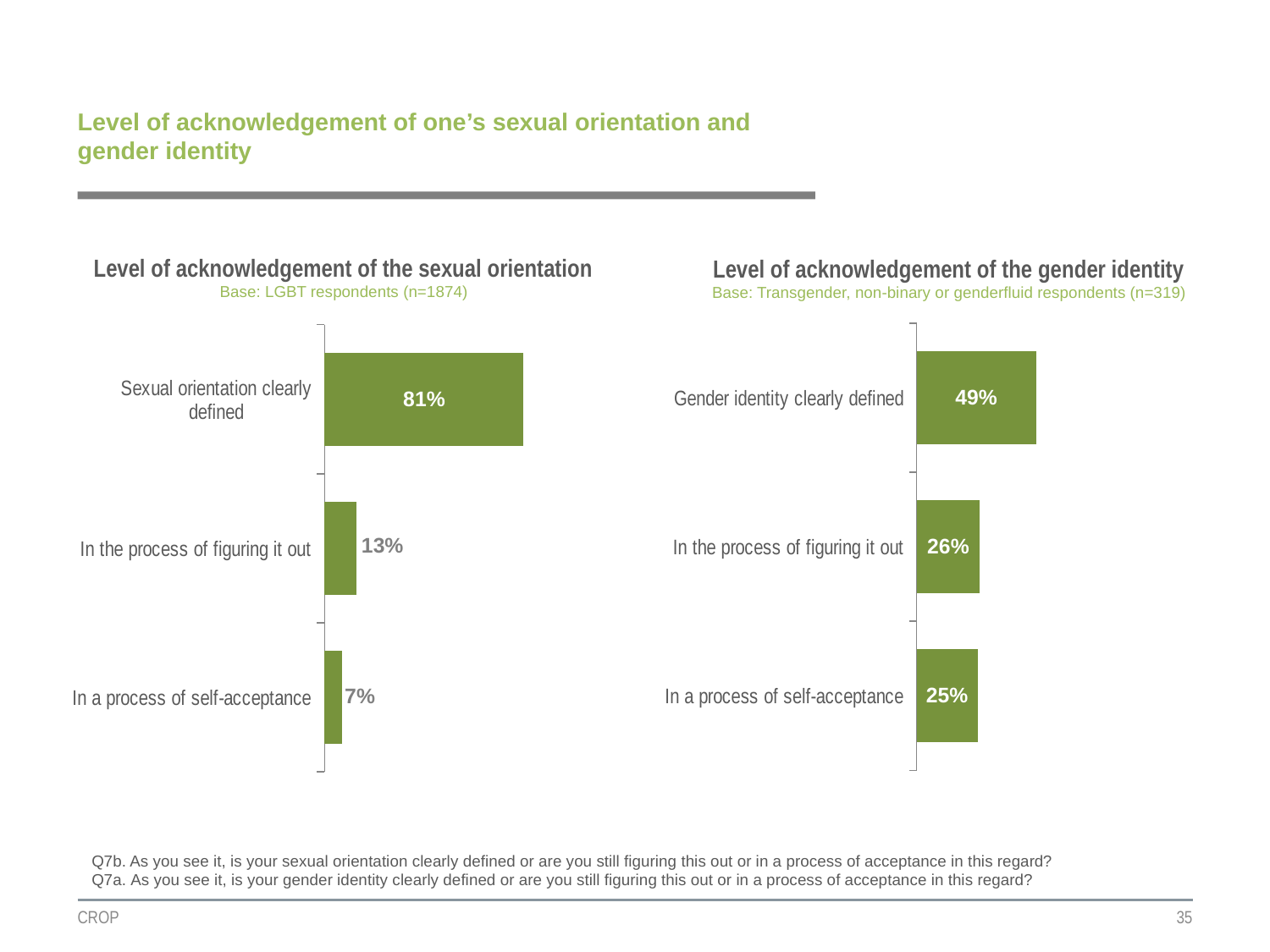
In the 'Level of acknowledgement of the sexual orientation' chart, what is the difference between 'Sexual orientation clearly defined' and 'In the process of figuring it out'? 68% How many categories does the 'Level of acknowledgement of the gender identity' chart show? 3 In the 'Level of acknowledgement of the gender identity' chart, what is the value for 'In the process of figuring it out'? 26% What is the base sample size shown under the 'Level of acknowledgement of the sexual orientation' chart title? n=1874 In the 'Level of acknowledgement of the sexual orientation' chart, what is the value for 'Sexual orientation clearly defined'? 81% In the 'Level of acknowledgement of the gender identity' chart, which category has the highest value? Gender identity clearly defined What kind of chart is the 'Level of acknowledgement of the sexual orientation' chart? Bar chart In the 'Level of acknowledgement of the gender identity' chart, what is the difference between 'Gender identity clearly defined' and 'In a process of self-acceptance'? 24% In the 'Level of acknowledgement of the sexual orientation' chart, what is the value for 'In a process of self-acceptance'? 7% In the 'Level of acknowledgement of the sexual orientation' chart, which category has the lowest value? In a process of self-acceptance What is the base sample size shown under the 'Level of acknowledgement of the gender identity' chart title? n=319 Which is larger: 'In the process of figuring it out' in the sexual orientation chart or 'In the process of figuring it out' in the gender identity chart? In the process of figuring it out in the gender identity chart